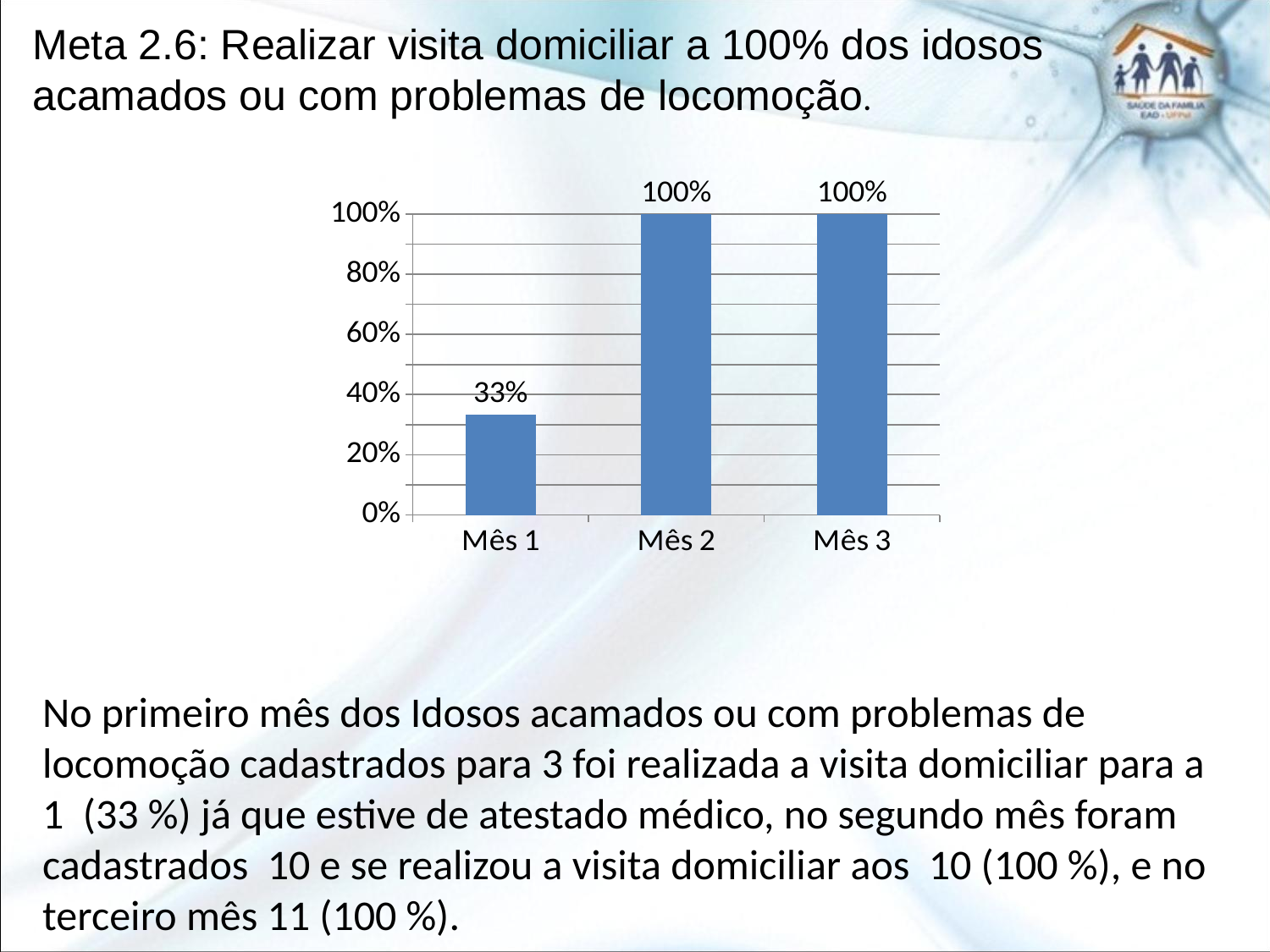
Do the values for Mês 2 and Mês 3 differ? No, both are 100% Which category has the lowest value? Mês 1 Do the values rise or fall from Mês 1 to Mês 2? rise What is the value for Mês 2? 100% What is the highest tick shown on the y axis? 100% How many categories are shown on the x axis? 3 What kind of chart is shown on the slide? bar chart Is the value for Mês 1 greater or less than 40%? less Which is larger, the value for Mês 1 or the value for Mês 3? Mês 3 What is the value for Mês 1? 33% What is the difference between the values for Mês 2 and Mês 1? 67% What is the value for Mês 3? 100%